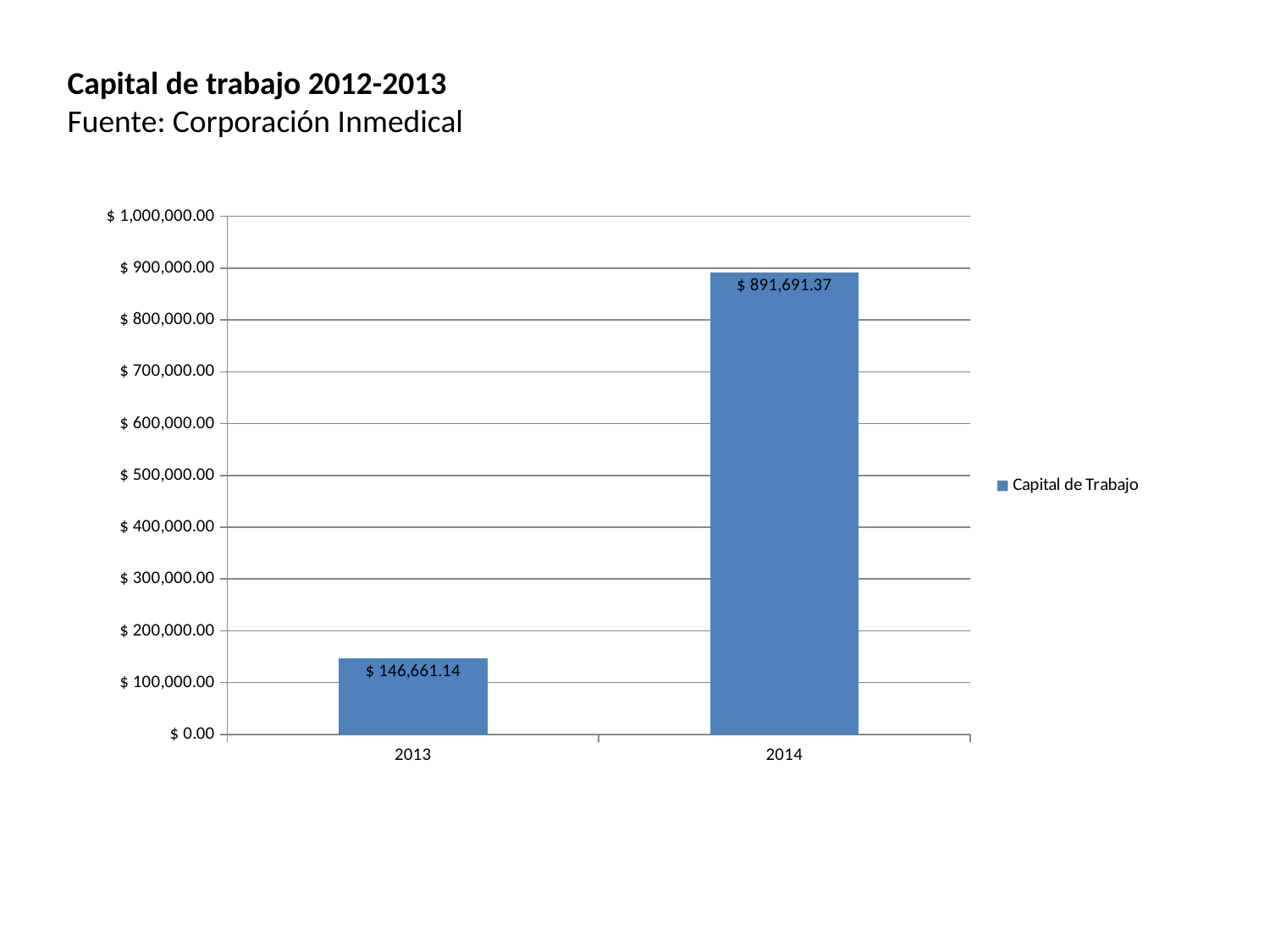
Is the value for 2014 greater or less than $ 800,000.00? greater How many series does the legend list? 1 How many categories are shown on the x axis? 2 Which year has the lowest value? 2013 What is the difference between the values for 2014 and 2013? $ 745,030.23 Is the value for 2013 greater or less than $ 200,000.00? less What is the value for 2014? $ 891,691.37 What kind of chart is shown? bar chart What is the value for 2013? $ 146,661.14 What series name is shown in the legend? Capital de Trabajo Which year has the highest value? 2014 Which is larger, the value for 2013 or the value for 2014? 2014